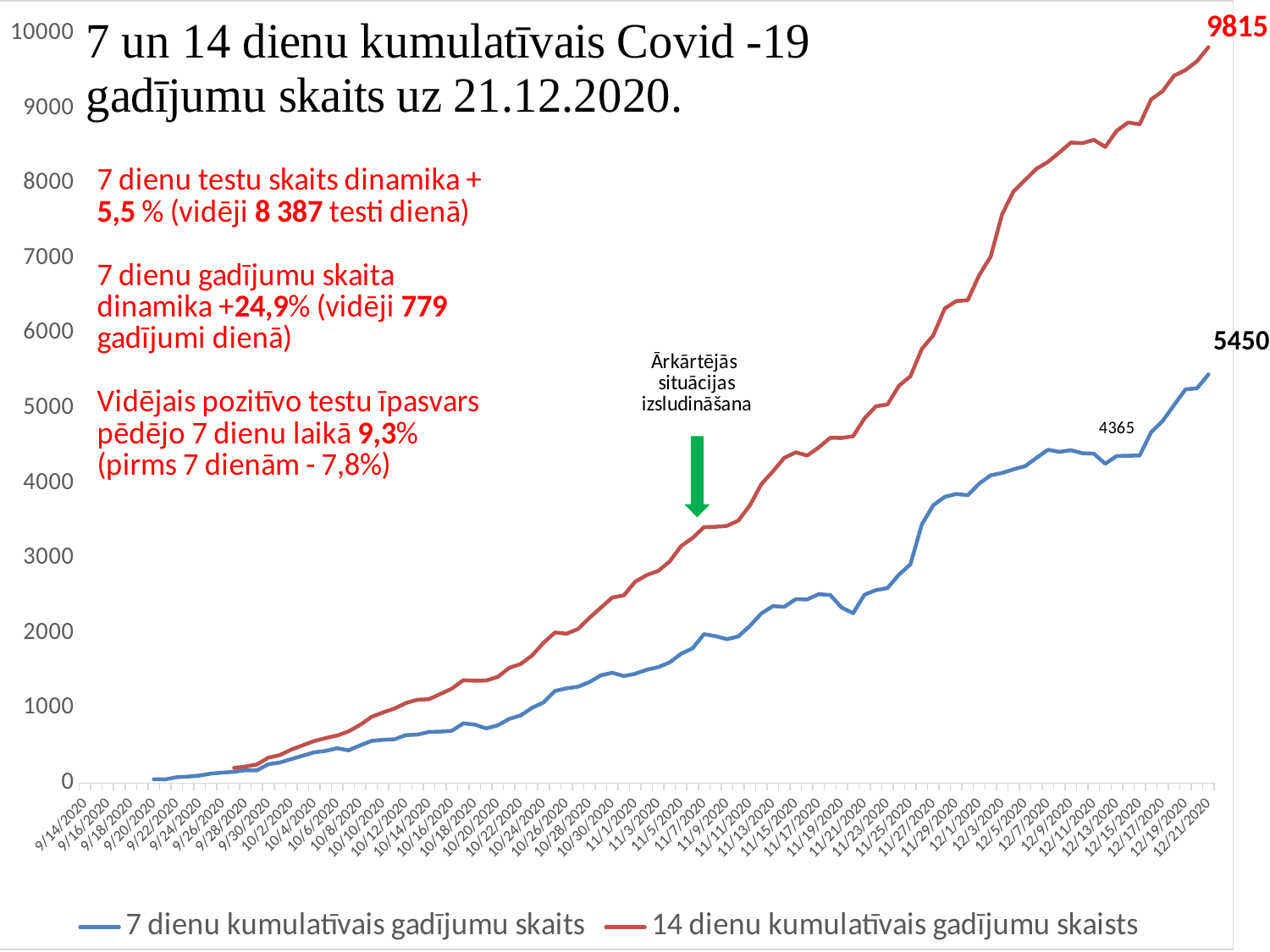
Which series ends higher on 12/21/2020, the 7-day or the 14-day cumulative series? 14 dienu kumulatīvais gadījumu skaists What event does the green arrow annotation on the chart mark? Ārkārtējās situācijas izsludināšana Is the value of the 7 dienu kumulatīvais gadījumu skaits series on 11/1/2020 greater or less than 2000? less What is the final labelled value of the 7 dienu kumulatīvais gadījumu skaits series? 5450 Is the value of the 14 dienu kumulatīvais gadījumu skaists series on 12/1/2020 greater or less than 6000? greater What is the final labelled value of the 14 dienu kumulatīvais gadījumu skaists series? 9815 What is the difference between the final labelled values of the 14-day series (9815) and the 7-day series (5450)? 4365 What kind of chart is shown on the slide? line chart How many series does the legend list? 2 What colour is the line for the 14 dienu kumulatīvais gadījumu skaists series? red Do the values of the 14-day cumulative series rise or fall along the x axis? rise